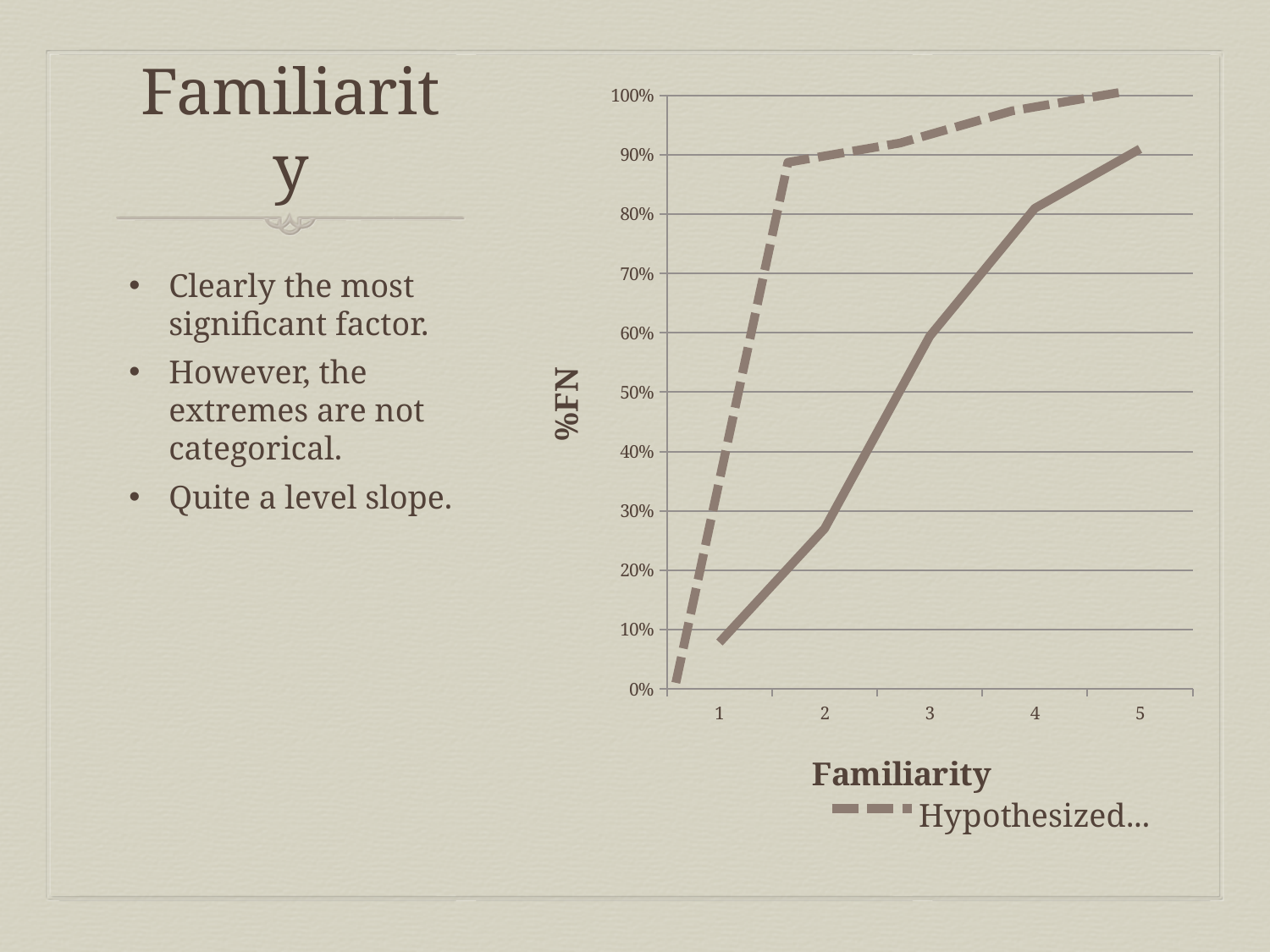
Is the value of the solid line at familiarity 3 greater or less than 50%? greater What is the title of the x axis of the chart? Familiarity Is the value of the solid line at familiarity 1 greater or less than 10%? less Is the value of the solid line at familiarity 2 greater or less than 30%? less How many lines are plotted on the chart? 2 What is the title of the y axis of the chart? %FN Does the solid line rise or fall as familiarity increases from 1 to 5? rise At familiarity 2, which line is higher: the dashed Hypothesized line or the solid line? the dashed Hypothesized line How many familiarity levels are marked on the x axis of the chart? 5 What kind of chart is shown on the slide? line chart